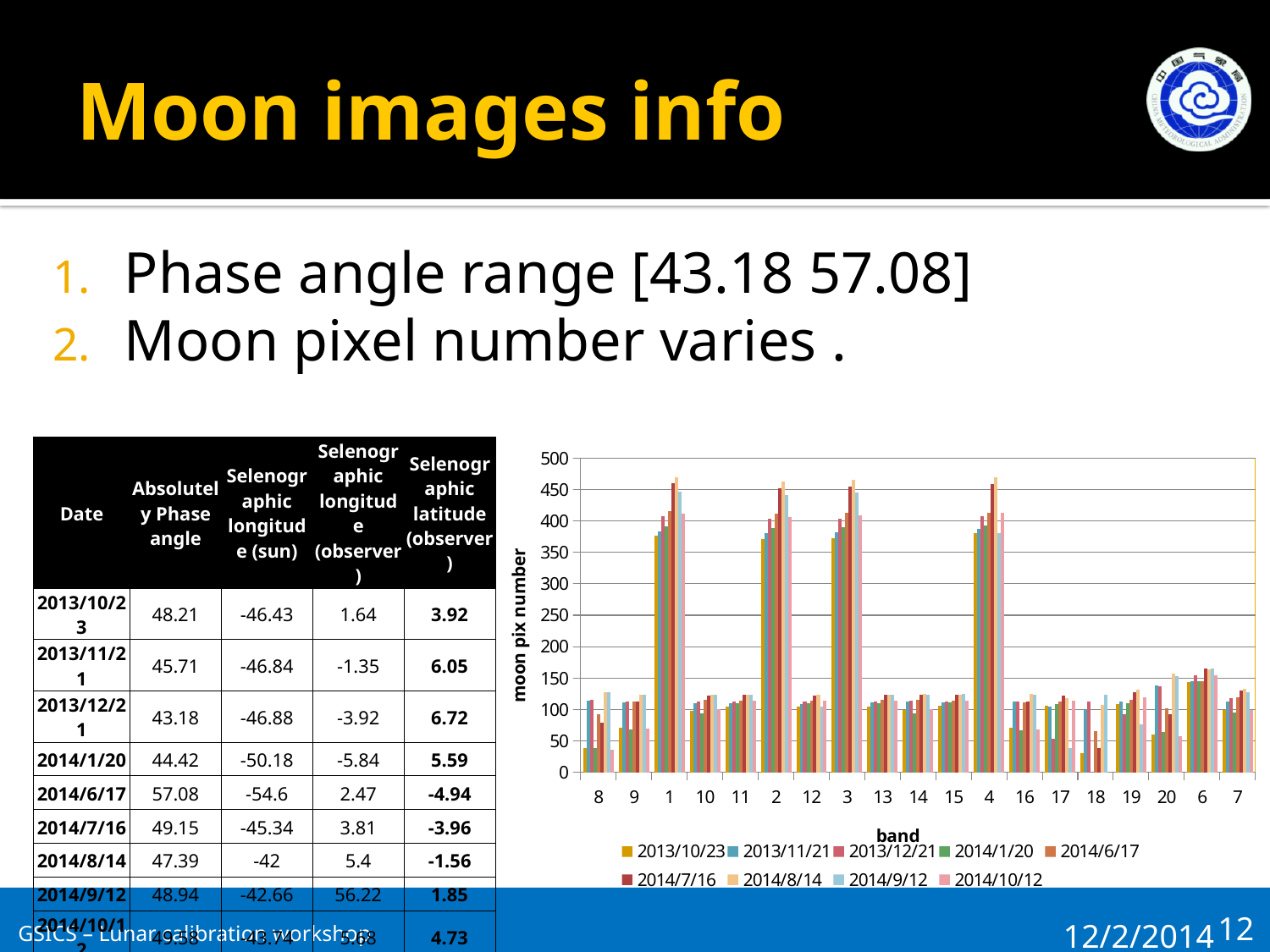
Are the values for band 8 greater or less than 200? less Are the values for band 4 greater or less than 350? greater What is the title of the chart's horizontal axis? band Are the values for band 1 greater or less than 300? greater Which has larger moon pix number values, band 9 or band 3? band 3 What is the title of the chart's vertical axis? moon pix number How many series does the chart's legend list? 9 How many band categories are shown along the x axis of the chart? 19 What kind of chart is shown on the slide? bar chart Which has larger moon pix number values, band 2 or band 12? band 2